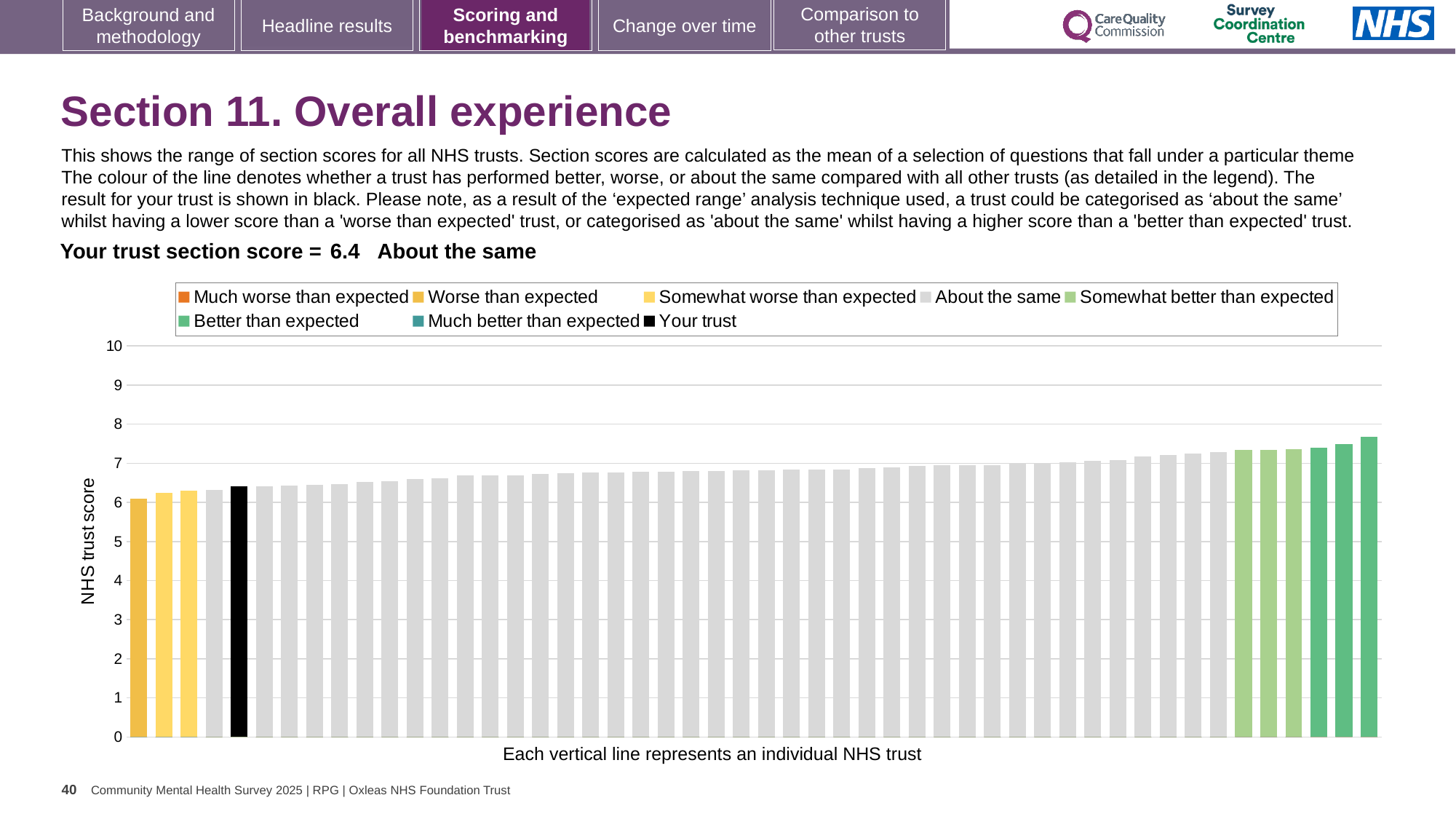
How many entries does the chart legend list? 8 Is the value of the tallest bar on the right of the chart greater or less than 7? greater Is the value of the black bar for your trust greater or less than 8? less What is the label on the vertical axis of the chart? NHS trust score Is the value of the black bar for your trust greater or less than 5? greater What is the section score for your trust shown on the slide? 6.4 Do the bar values rise or fall from left to right along the x axis? rise What colour is the bar representing your trust in the chart? black What kind of chart is shown on the slide? bar chart